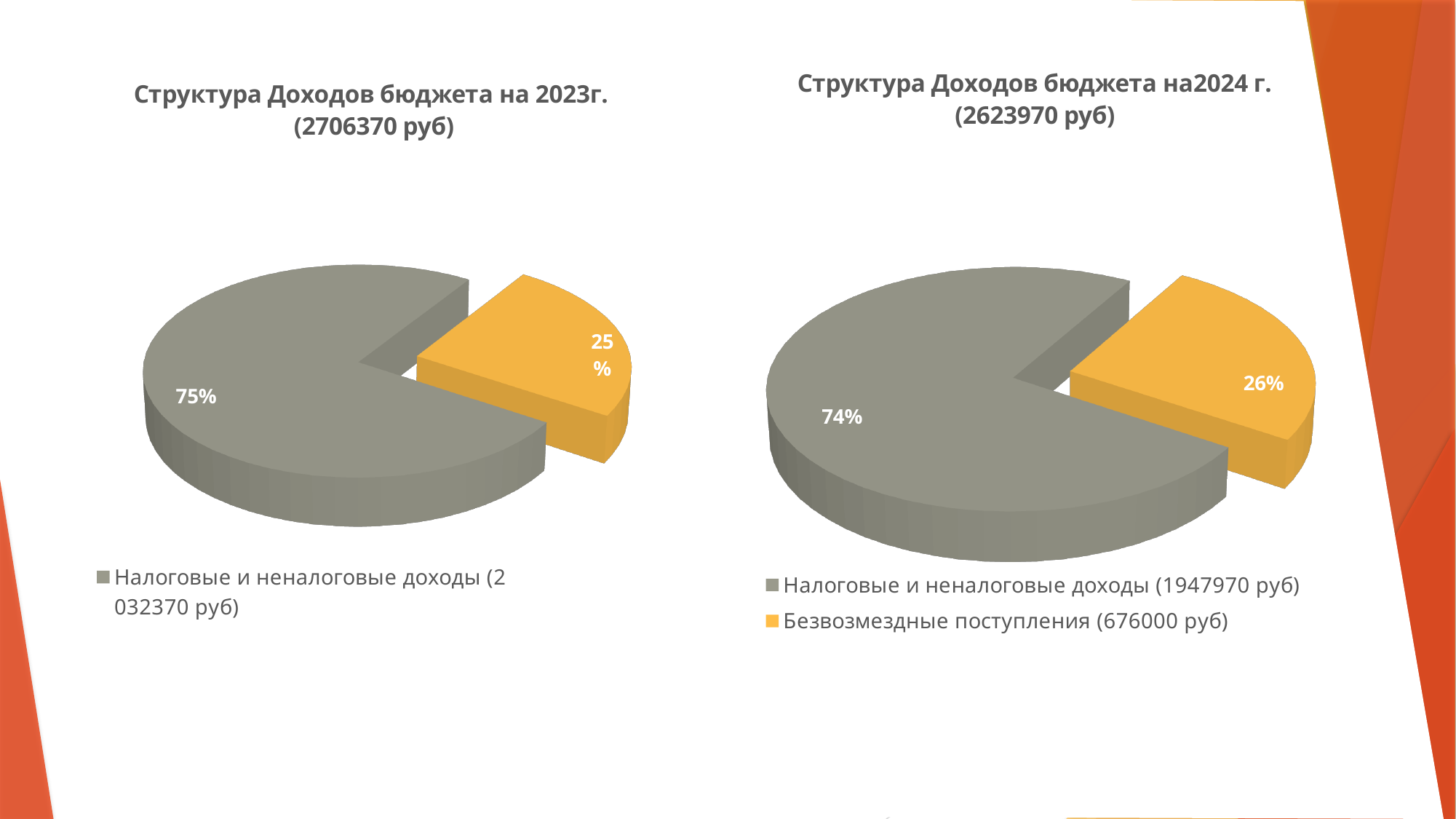
In the chart titled "Структура Доходов бюджета на2024 г.", how many entries does the legend list? 2 In the chart titled "Структура Доходов бюджета на2024 г.", what is the difference in percentage points between "Налоговые и неналоговые доходы" and "Безвозмездные поступления"? 48 In the chart titled "Структура Доходов бюджета на 2023г.", how many slices does the pie have? 2 In the chart titled "Структура Доходов бюджета на2024 г.", which category has the smallest share? Безвозмездные поступления In the chart titled "Структура Доходов бюджета на2024 г.", which category has the largest share? Налоговые и неналоговые доходы What type of chart is used on this slide? Pie chart In the chart titled "Структура Доходов бюджета на2024 г.", what share does "Безвозмездные поступления" have? 26% In the chart titled "Структура Доходов бюджета на2024 г.", what share does "Налоговые и неналоговые доходы" have? 74% In the chart titled "Структура Доходов бюджета на2024 г.", what colour is the "Безвозмездные поступления" slice? Orange Which is larger: the share of "Налоговые и неналоговые доходы" in the 2023 chart or in the 2024 chart? 2023 chart In the chart titled "Структура Доходов бюджета на2024 г.", how many slices does the pie have? 2 In the chart titled "Структура Доходов бюджета на 2023г.", what share does "Налоговые и неналоговые доходы" have? 75%